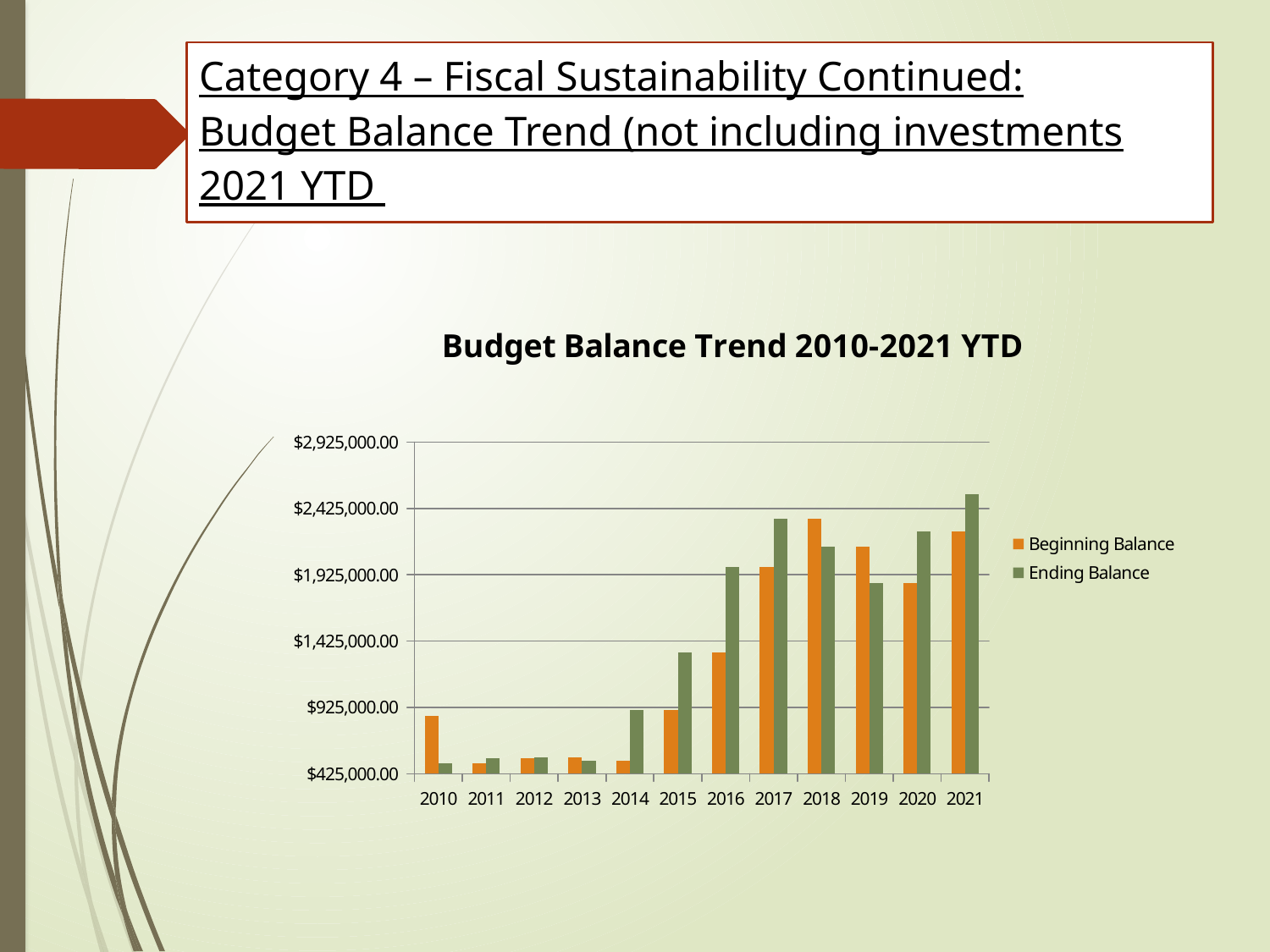
Is the Ending Balance for 2021 greater or less than $2,425,000.00? greater How many series does the legend list? 2 Which year has the highest Ending Balance? 2021 How many years are shown on the x axis? 12 Which year has the lowest Ending Balance? 2010 In 2010, which is larger, the Beginning Balance or the Ending Balance? Beginning Balance What is the title of the chart? Budget Balance Trend 2010-2021 YTD Is the Ending Balance for 2015 greater or less than $1,425,000.00? less Is the Beginning Balance for 2010 greater or less than $925,000.00? less What kind of chart is shown on the slide? Bar chart Which year has the highest Beginning Balance? 2018 In 2021, which is larger, the Beginning Balance or the Ending Balance? Ending Balance